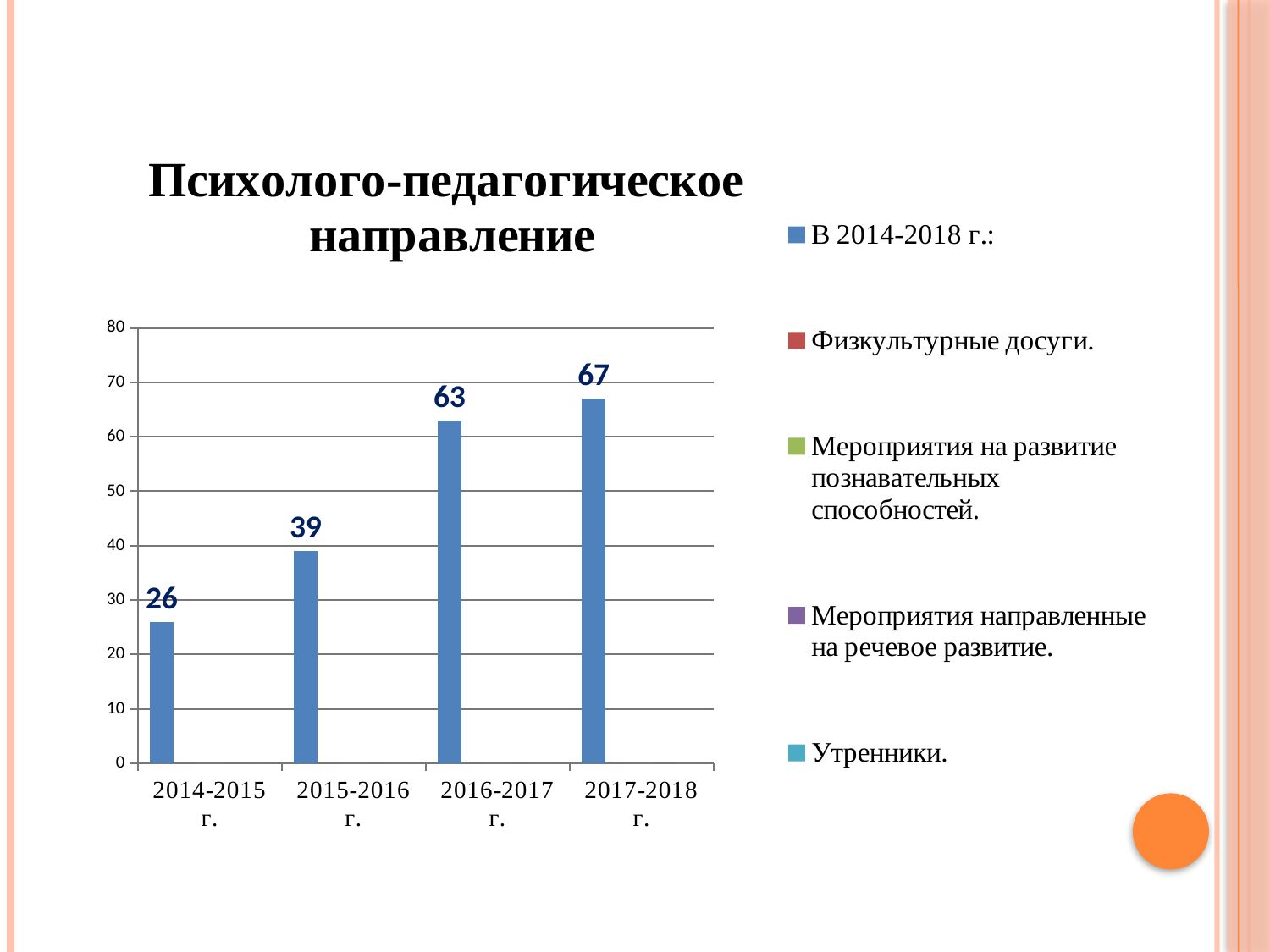
Which is larger, the value for 2015-2016 г. or the value for 2014-2015 г.? 2015-2016 г. Do the values rise or fall from 2014-2015 г. to 2017-2018 г.? rise What is the value for 2015-2016 г.? 39 Which year has the lowest value? 2014-2015 г. Which year has the highest value? 2017-2018 г. Is the value for 2016-2017 г. greater or less than 50? greater What kind of chart is shown on the slide? bar chart What is the value for 2016-2017 г.? 63 What is the difference between the values for 2016-2017 г. and 2015-2016 г.? 24 How many year categories are shown on the x axis? 4 What is the value for 2014-2015 г.? 26 What is the value for 2017-2018 г.? 67